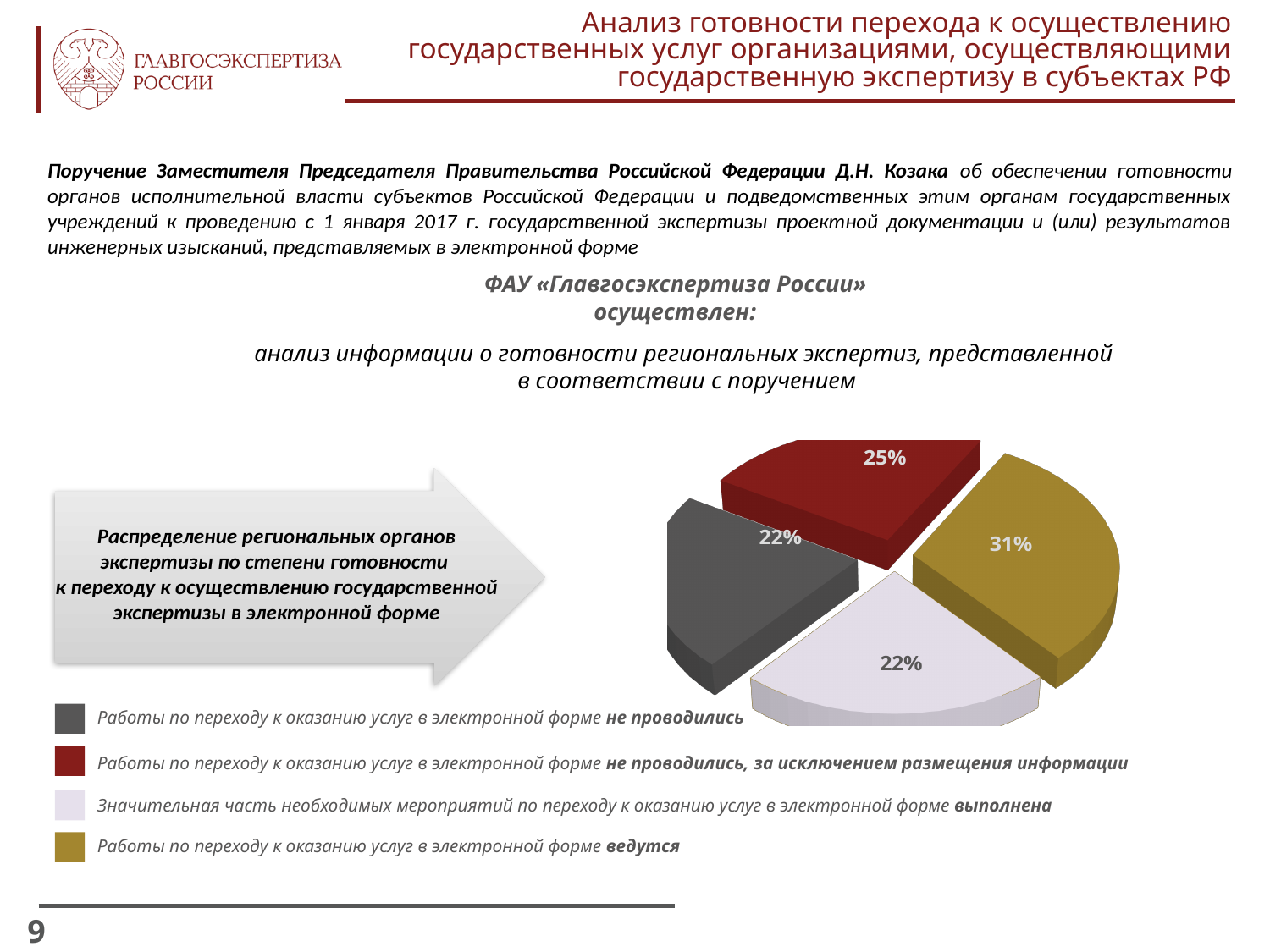
What share corresponds to the category where a significant part of the necessary measures has been completed ("выполнена")? 22% What share corresponds to the category where work on the transition was not carried out at all ("не проводились")? 22% What is the smallest percentage value shown on the pie chart? 22% What kind of chart is shown on the slide? pie chart How many slices does the pie chart have? 4 What is the difference between the largest slice (31%) and the slice for work not carried out except for posting information (25%)? 6% What colour is the slice representing the category where work is underway ("ведутся")? gold Which is larger: the share for work underway ("ведутся") or the share for work not carried out except for posting information? work underway ("ведутся"), 31% What share of regional expertise bodies falls into the category where work on the transition to electronic services is underway ("ведутся")? 31% What colour is the slice representing the category where work was not carried out at all ("не проводились")? dark grey What share corresponds to the category where work was not carried out except for posting information ("не проводились, за исключением размещения информации")? 25% Which category has the largest share in the pie chart? Работы по переходу к оказанию услуг в электронной форме ведутся